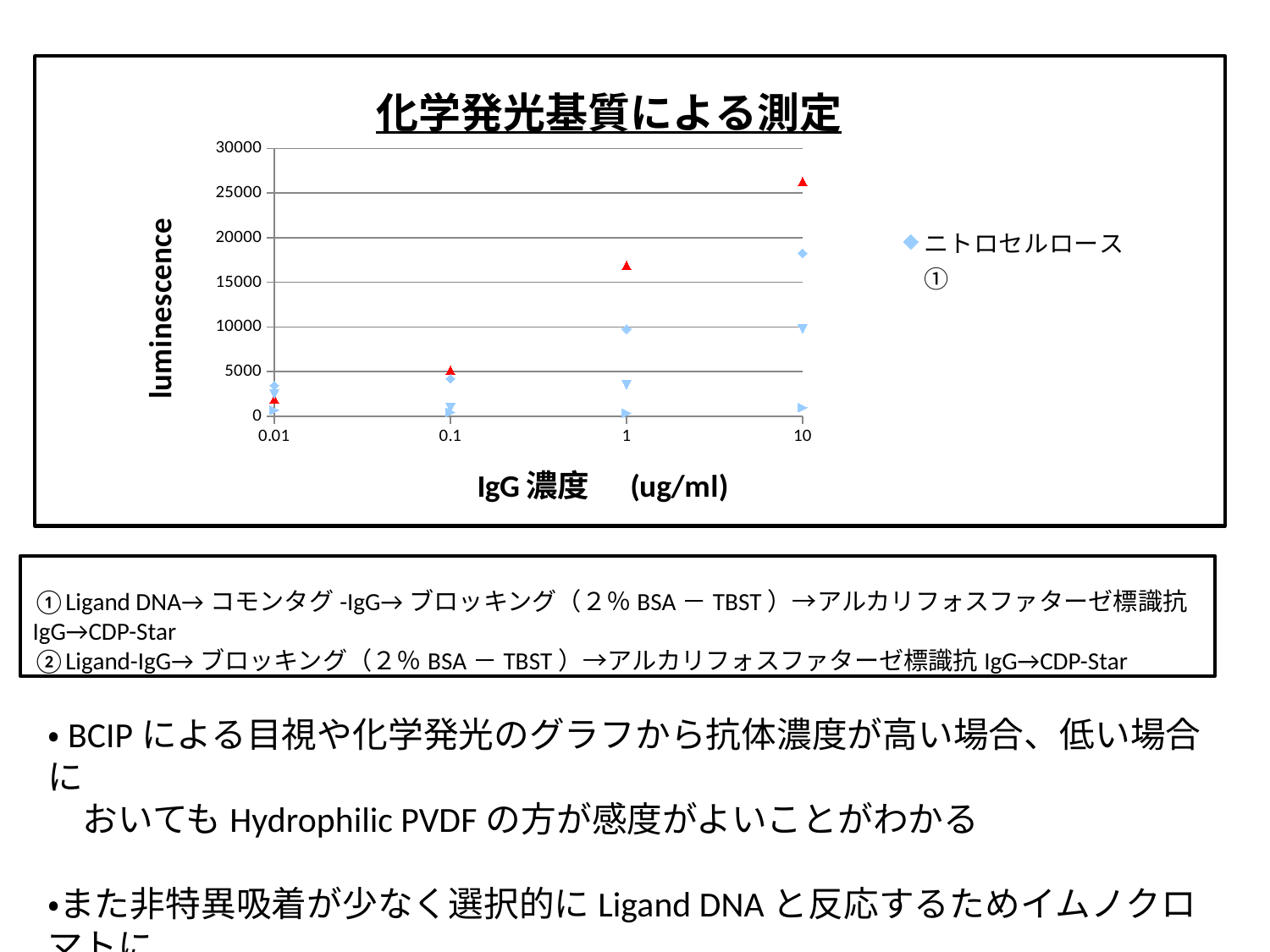
Do the values for ニトロセルロース① rise or fall as IgG 濃度 increases from 0.01 to 10? rise How many tick values are shown on the x axis (IgG 濃度) of the chart? 4 What kind of chart is shown on the slide? scatter chart Is the value for ニトロセルロース① at IgG 濃度 0.1 greater or less than 5000? less What is the highest value shown on the y axis of the chart? 30000 Is the value for ニトロセルロース① at IgG 濃度 1 greater or less than 5000? greater At which IgG 濃度 does ニトロセルロース① reach its highest value? 10 What is the title of the chart? 化学発光基質による測定 Is the value for ニトロセルロース① at IgG 濃度 10 greater or less than 15000? greater What is the label of the y axis of the chart? luminescence Which is larger for ニトロセルロース①: the value at IgG 濃度 1 or at IgG 濃度 10? 10